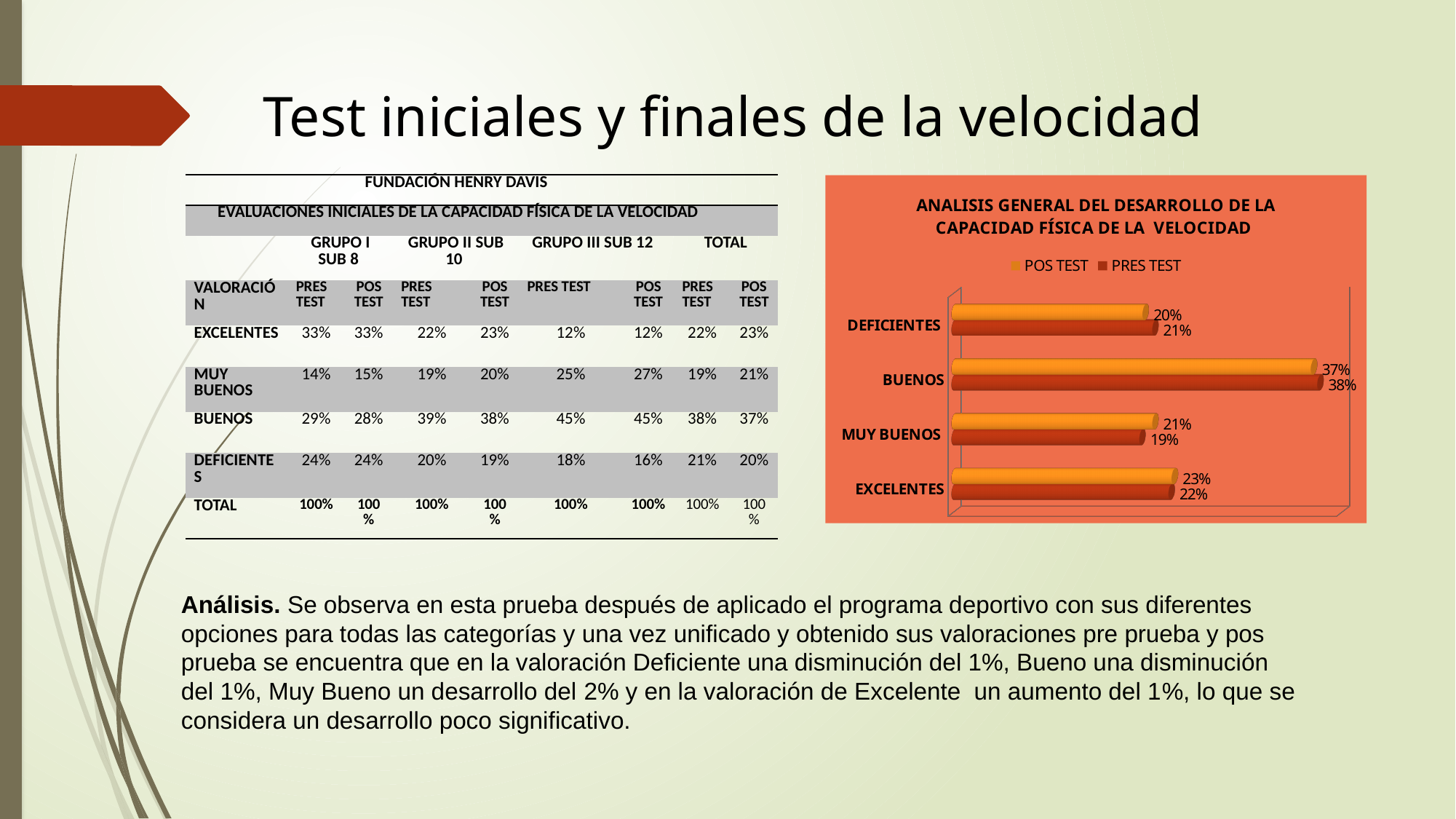
How many series does the chart legend list? 2 Which is larger for DEFICIENTES, the POS TEST value or the PRES TEST value? PRES TEST What is the PRES TEST value for MUY BUENOS? 19% What is the POS TEST value for BUENOS? 37% What is the POS TEST value for EXCELENTES? 23% What is the title of the chart? ANALISIS GENERAL DEL DESARROLLO DE LA CAPACIDAD FÍSICA DE LA VELOCIDAD What type of chart is shown on the slide? bar chart What is the PRES TEST value for DEFICIENTES? 21% Which category has the highest POS TEST value? BUENOS How many categories are shown on the chart? 4 What is the difference between the PRES TEST and POS TEST values for MUY BUENOS? 2% Which category has the lowest PRES TEST value? MUY BUENOS